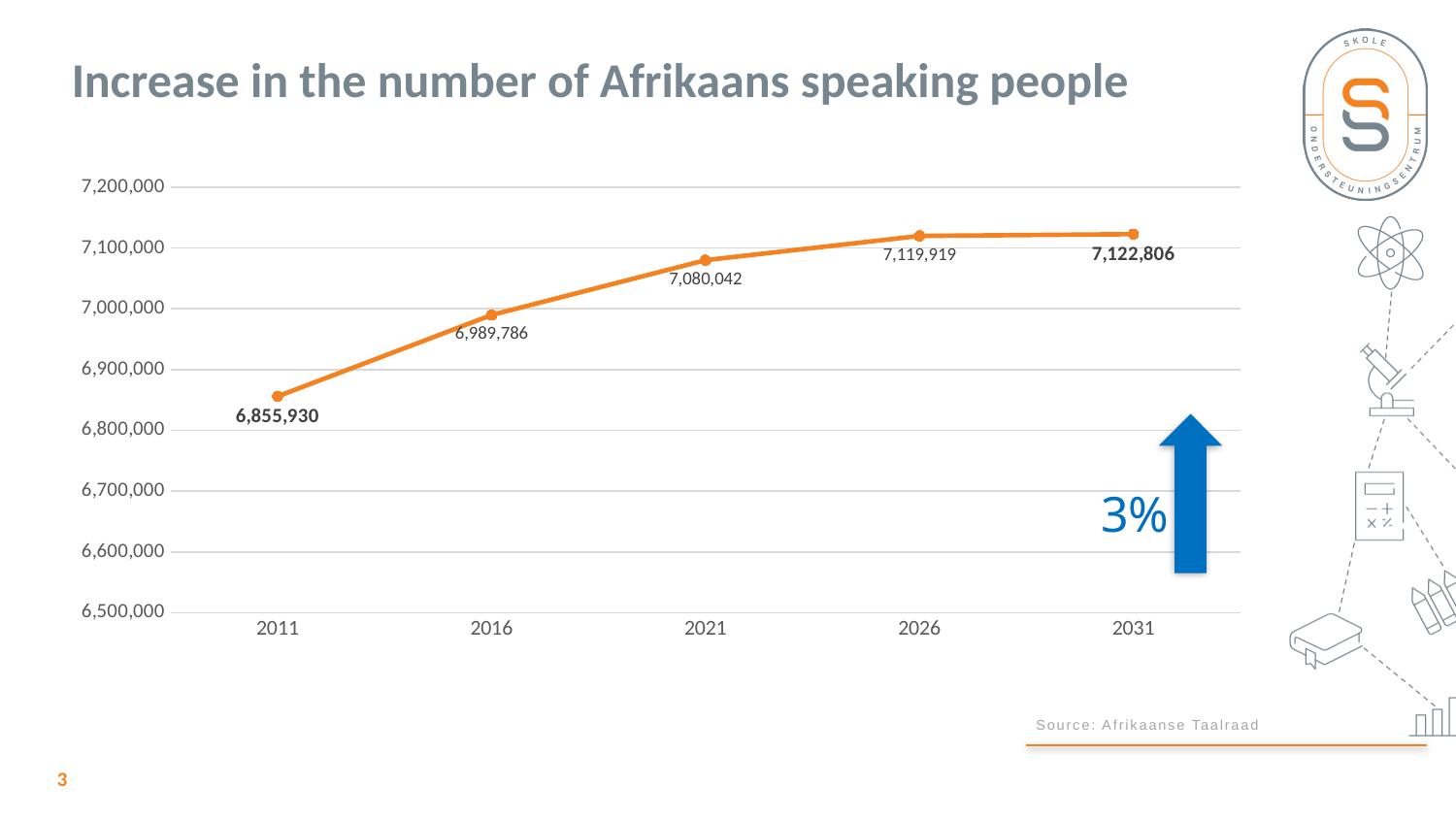
Which year has the highest number of Afrikaans speaking people? 2031 What type of chart is shown on the slide? Line chart What is the number of Afrikaans speaking people in 2031? 7,122,806 What is the number of Afrikaans speaking people in 2021? 7,080,042 How many years are plotted on the x axis? 5 What is the number of Afrikaans speaking people in 2016? 6,989,786 What is the number of Afrikaans speaking people in 2011? 6,855,930 Which year has the lowest number of Afrikaans speaking people? 2011 What is the number of Afrikaans speaking people in 2026? 7,119,919 Do the values rise or fall from 2011 to 2031? Rise What is the difference between the values for 2016 and 2011? 133,856 What is the difference between the number of Afrikaans speaking people in 2031 and in 2011? 266,876